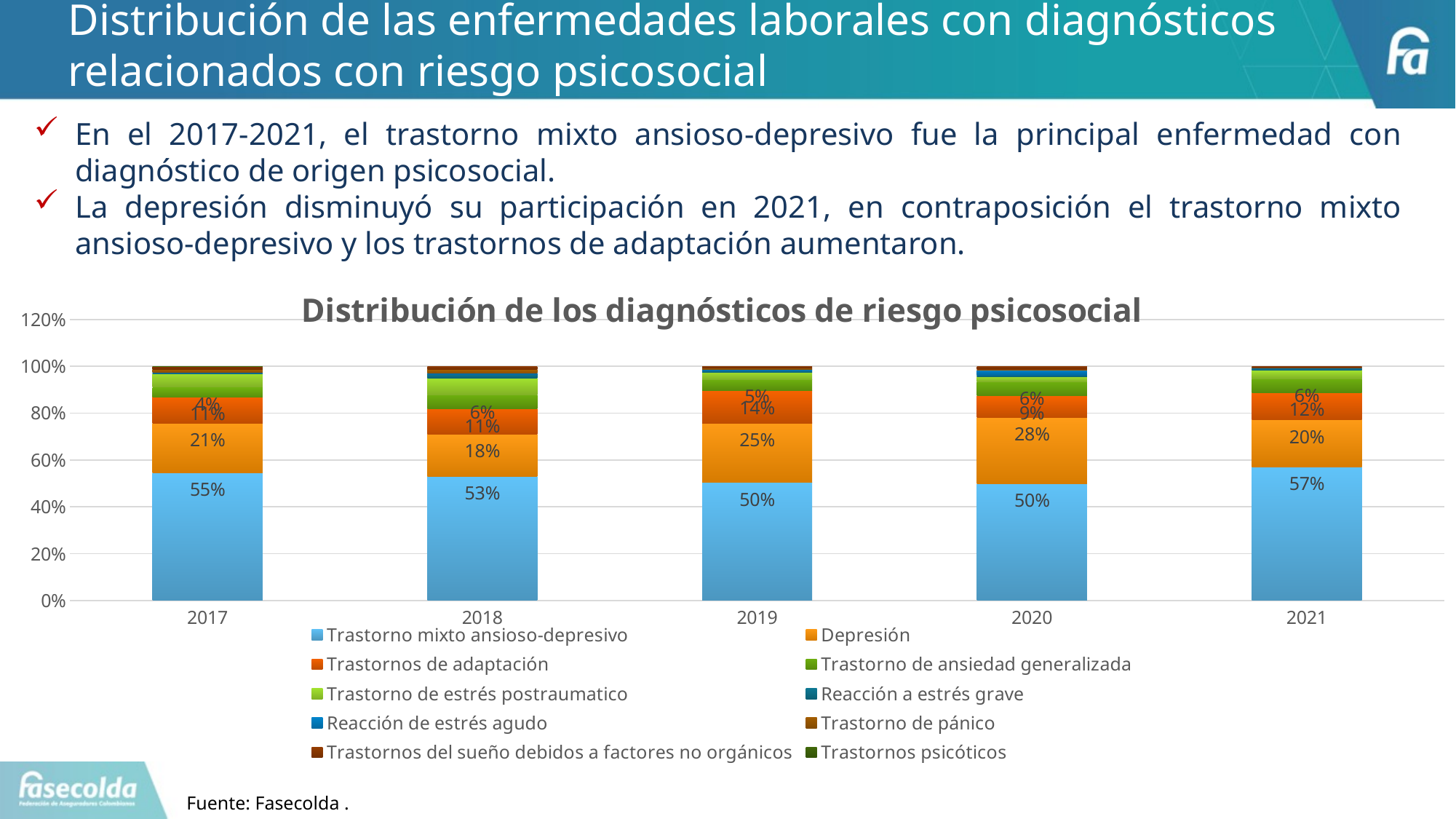
In which year is the share of Trastorno mixto ansioso-depresivo highest? 2021 What is the share of Trastornos de adaptación in 2019? 14% What is the share of Trastorno de ansiedad generalizada in 2017? 4% In which year is the share of Depresión lowest? 2018 How many series does the legend list? 10 What is the title of the chart? Distribución de los diagnósticos de riesgo psicosocial Which is larger: the Trastornos de adaptación share in 2019 or in 2020? 2019 What is the share of Trastorno mixto ansioso-depresivo in 2021? 57% What is the share of Depresión in 2020? 28% What is the difference between the Depresión share in 2020 and in 2021? 8% What kind of chart is shown on the slide? Stacked bar chart How many years are shown on the x axis? 5